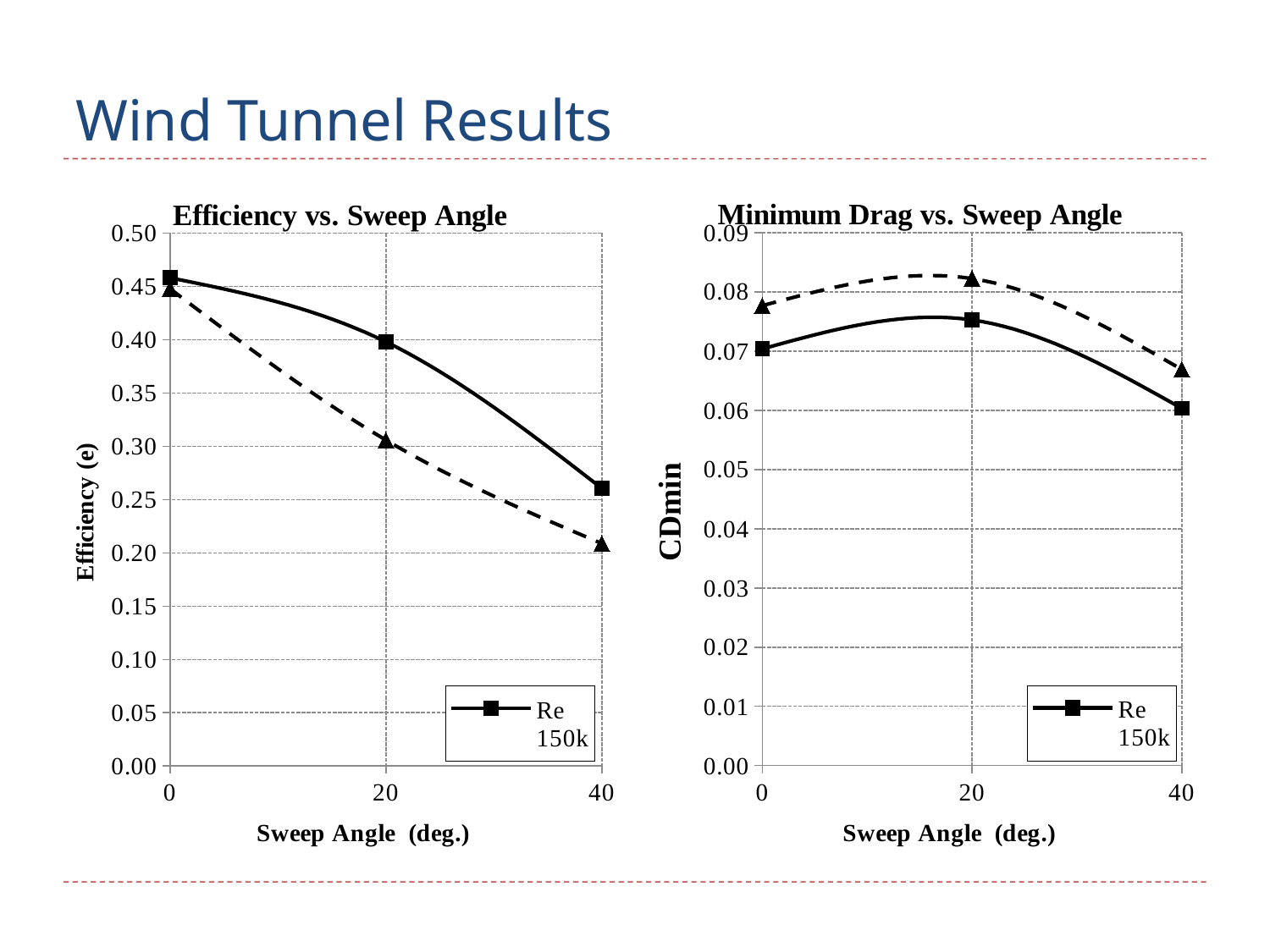
In the "Efficiency vs. Sweep Angle" chart, at 20 degrees, which line is higher: the solid line with square markers or the dashed line with triangle markers? the solid line with square markers How many series does the legend of the "Minimum Drag vs. Sweep Angle" chart list? 1 In the "Efficiency vs. Sweep Angle" chart, is the Re 150k efficiency at 40 degrees greater or less than 0.30? less In the "Minimum Drag vs. Sweep Angle" chart, at which sweep angle is the Re 150k CDmin highest? 20 In the "Efficiency vs. Sweep Angle" chart, does the Re 150k efficiency rise or fall as the sweep angle increases from 0 to 40 degrees? fall In the "Efficiency vs. Sweep Angle" chart, at which sweep angle is the Re 150k efficiency highest? 0 In the "Minimum Drag vs. Sweep Angle" chart, is the Re 150k CDmin at 40 degrees greater or less than 0.07? less What is the y-axis label of the "Minimum Drag vs. Sweep Angle" chart? CDmin In the "Efficiency vs. Sweep Angle" chart, is the Re 150k efficiency at 0 degrees greater or less than 0.40? greater What kind of chart is the "Efficiency vs. Sweep Angle" chart? line chart In the "Minimum Drag vs. Sweep Angle" chart, at which sweep angle is the Re 150k CDmin lowest? 40 How many sweep angle data points are plotted for the Re 150k series in the "Minimum Drag vs. Sweep Angle" chart? 3